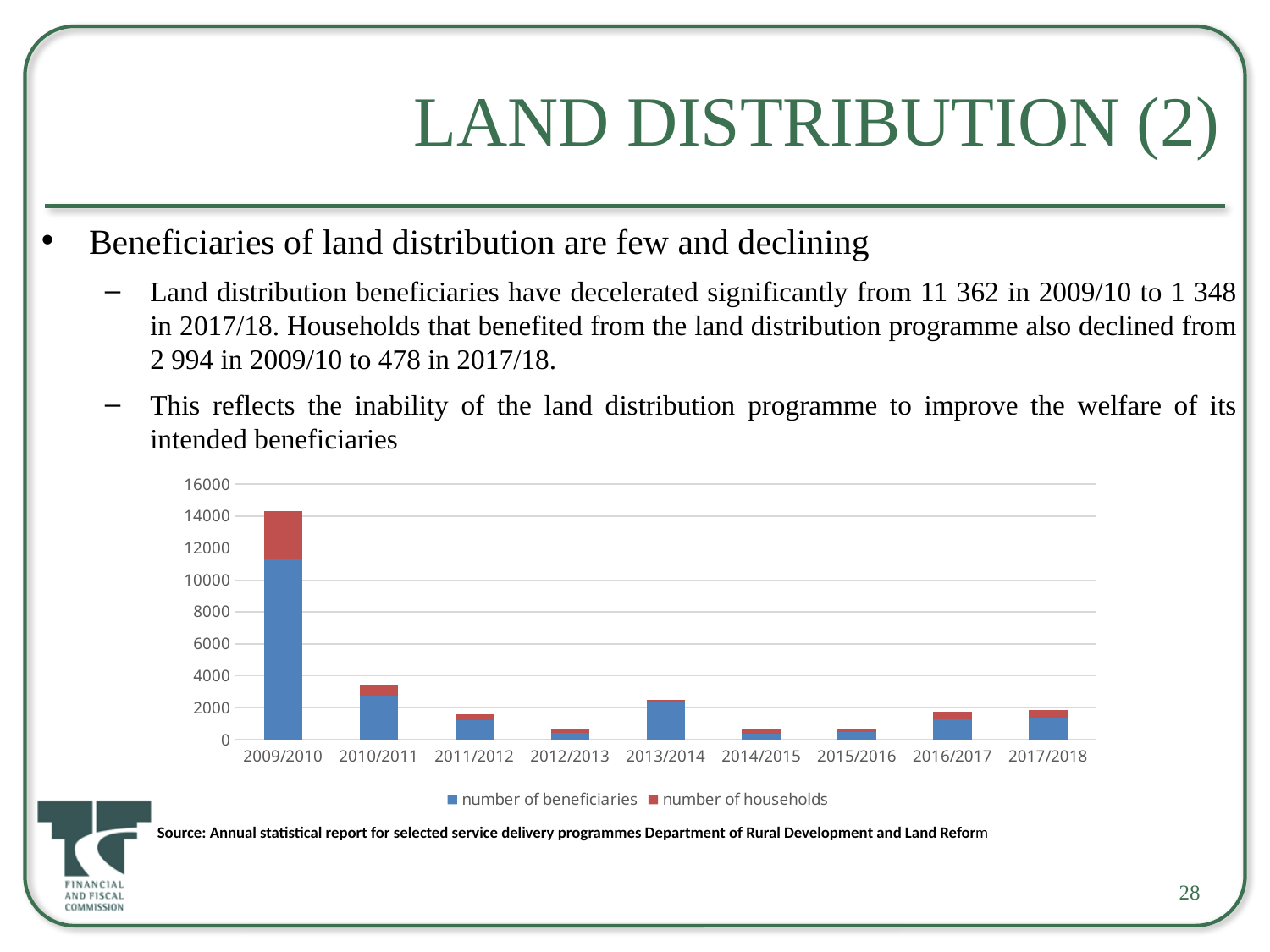
Is the total stacked bar for 2012/2013 greater or less than 2000? less Which year has the highest number of beneficiaries in the chart? 2009/2010 Is the total stacked bar for 2009/2010 greater or less than 12000? greater Is the number of beneficiaries for 2010/2011 greater or less than 4000? less What kind of chart is shown on the slide? bar chart Which colour represents the number of households series in the chart? red How many financial-year categories are shown on the x axis of the chart? 9 Which year has the larger number of beneficiaries, 2010/2011 or 2011/2012? 2010/2011 Which year has the larger number of beneficiaries, 2012/2013 or 2013/2014? 2013/2014 Overall, do the number of beneficiaries rise or fall from 2009/2010 to 2017/2018? fall How many series does the chart legend list? 2